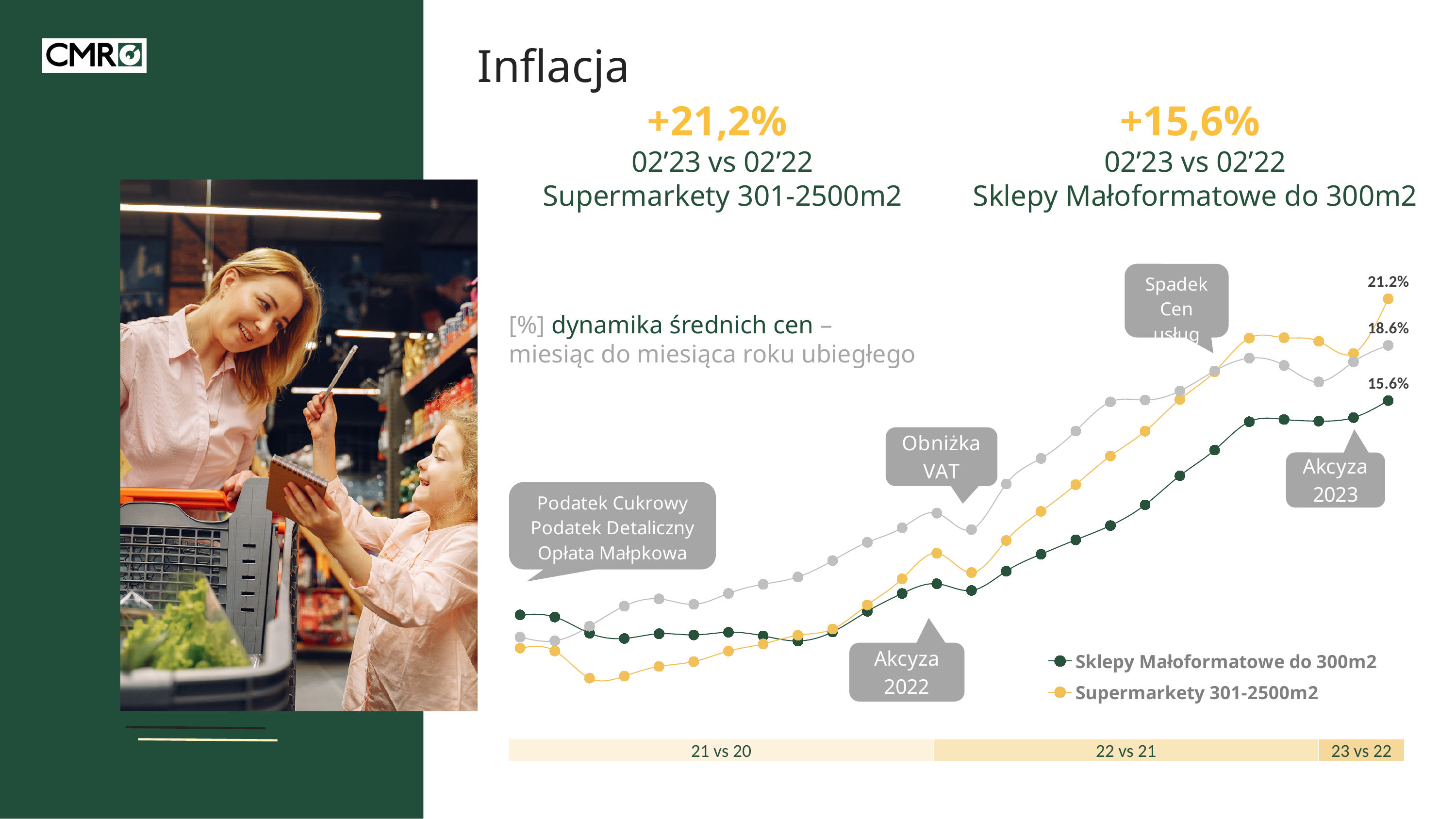
Which legend series ends with the highest labelled value? Supermarkety 301-2500m2 How many comparison periods are labelled along the bottom of the chart? 3 What kind of chart is shown on the slide? line chart What is the final labelled value for the Sklepy Małoformatowe do 300m2 series? 15.6% What is the label of the last period band at the bottom of the chart? 23 vs 22 Which legend series ends with the lowest labelled value? Sklepy Małoformatowe do 300m2 Which series in the legend is drawn in yellow? Supermarkety 301-2500m2 At the end of the chart, which series is higher: Supermarkety 301-2500m2 or Sklepy Małoformatowe do 300m2? Supermarkety 301-2500m2 What is the final labelled value for the Supermarkety 301-2500m2 series? 21.2% What is the difference between the final labelled values of Supermarkety 301-2500m2 (21.2%) and Sklepy Małoformatowe do 300m2 (15.6%)? 5.6 percentage points Do the values of the Sklepy Małoformatowe do 300m2 series generally rise or fall from left to right across the chart? rise How many series does the chart legend list? 2